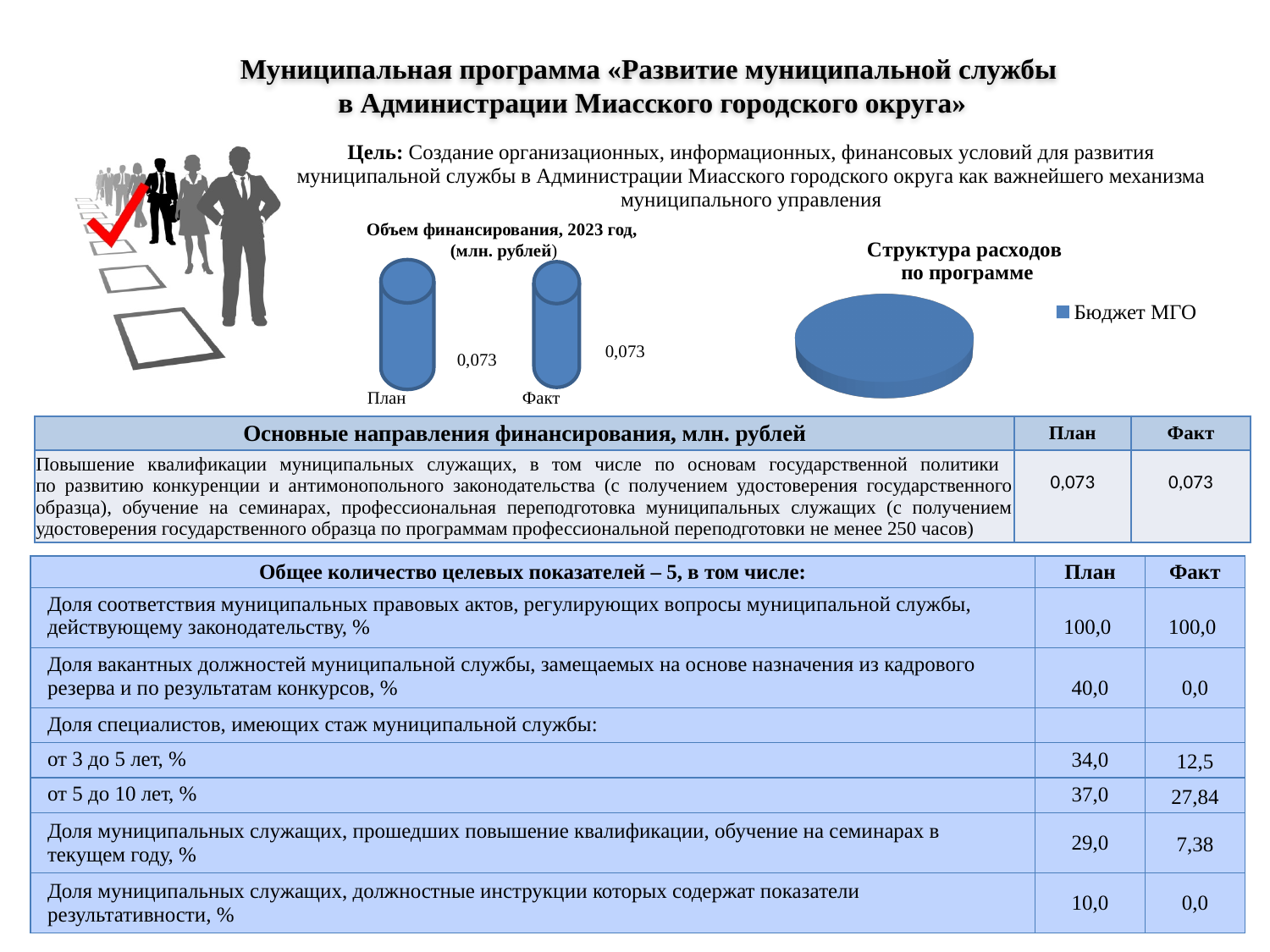
In the chart titled «Объем финансирования, 2023 год, (млн. рублей)», how many categories are plotted? 2 What kind of chart is the one titled «Объем финансирования, 2023 год, (млн. рублей)»? bar chart In the chart titled «Объем финансирования, 2023 год, (млн. рублей)», what is the value for План? 0,073 How many entries does the legend of the chart titled «Структура расходов по программе» list? 1 In the chart titled «Объем финансирования, 2023 год, (млн. рублей)», what is the difference between the План and Факт values? 0 In the chart titled «Объем финансирования, 2023 год, (млн. рублей)», what is the value for Факт? 0,073 In the chart titled «Объем финансирования, 2023 год, (млн. рублей)», what are the two category labels on the x axis? План, Факт What is the legend entry in the chart titled «Структура расходов по программе»? Бюджет МГО What kind of chart is the one titled «Структура расходов по программе»? pie chart In the chart titled «Структура расходов по программе», how many slices does the pie have? 1